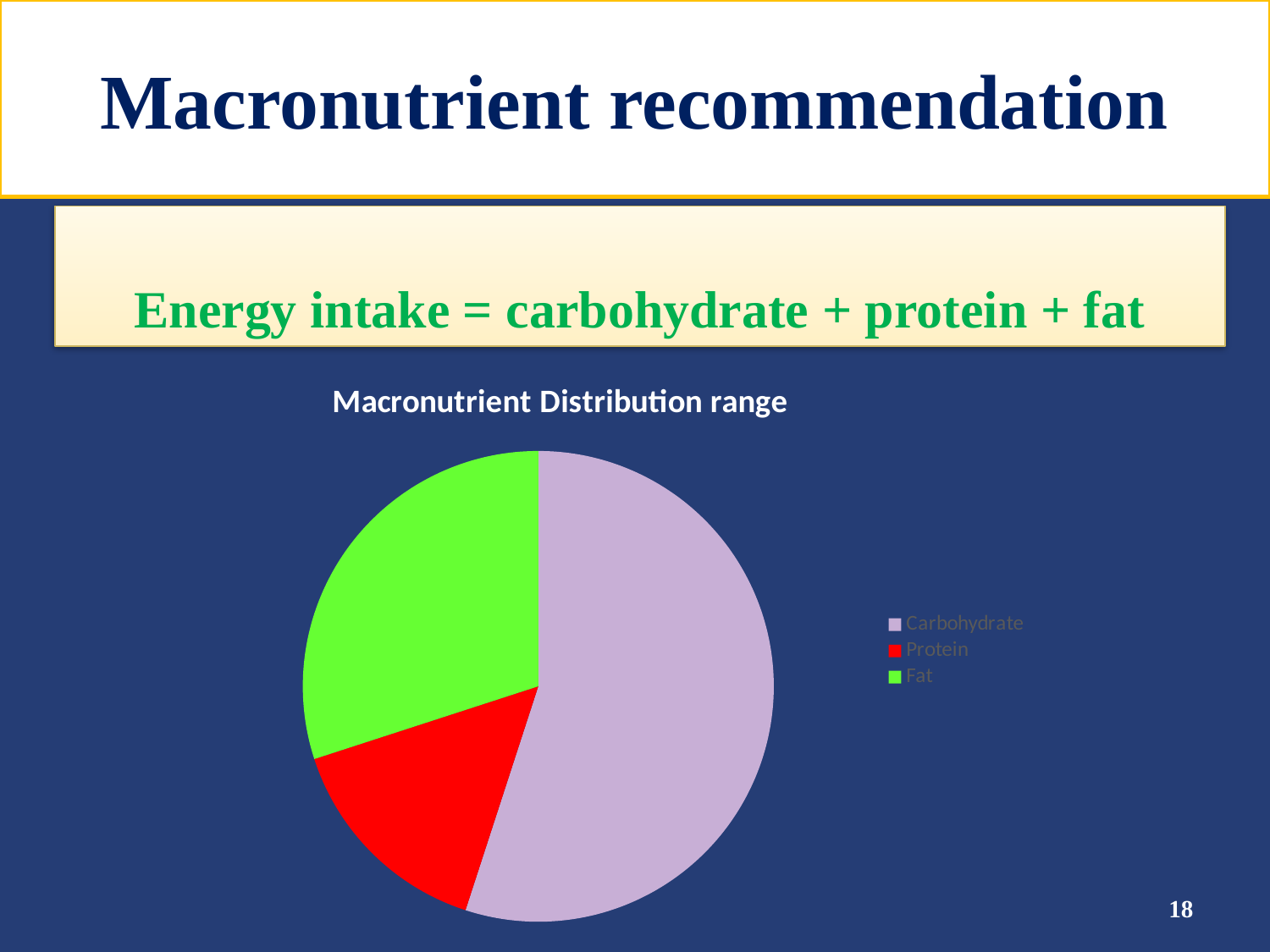
What kind of chart is shown on the slide? pie chart Which macronutrient has the largest slice of the pie? Carbohydrate Which slice is larger, Carbohydrate or Fat? Carbohydrate Which colour represents Protein in the pie chart? red What is the title of the chart? Macronutrient Distribution range How many entries does the chart legend list? 3 Which macronutrient has the smallest slice of the pie? Protein How many slices does the pie chart have? 3 Which slice is larger, Fat or Protein? Fat